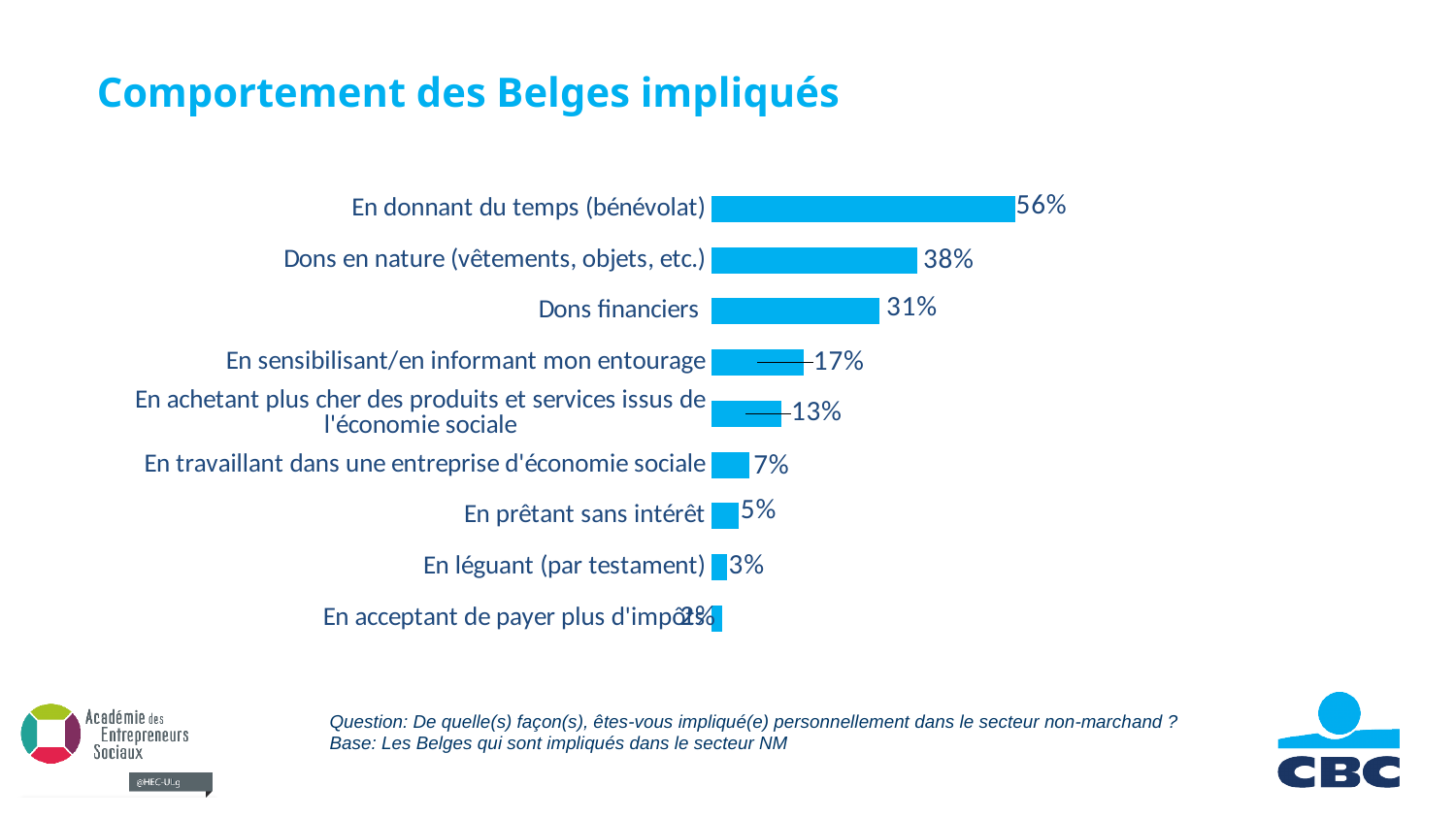
Which category has the highest value? En donnant du temps (bénévolat) What is the value for "Dons financiers"? 31% What is the title of the slide? Comportement des Belges impliqués How many categories are shown in the chart? 9 Which is larger, the value for "En prêtant sans intérêt" or the value for "En léguant (par testament)"? En prêtant sans intérêt What is the value for "En sensibilisant/en informant mon entourage"? 17% What is the value for "En travaillant dans une entreprise d'économie sociale"? 7% What kind of chart is shown on the slide? bar chart What is the difference between the values for "En donnant du temps (bénévolat)" and "Dons en nature (vêtements, objets, etc.)"? 18% What is the value for "En donnant du temps (bénévolat)"? 56% What is the difference between the values for "Dons financiers" and "En sensibilisant/en informant mon entourage"? 14% What is the value for "Dons en nature (vêtements, objets, etc.)"? 38%